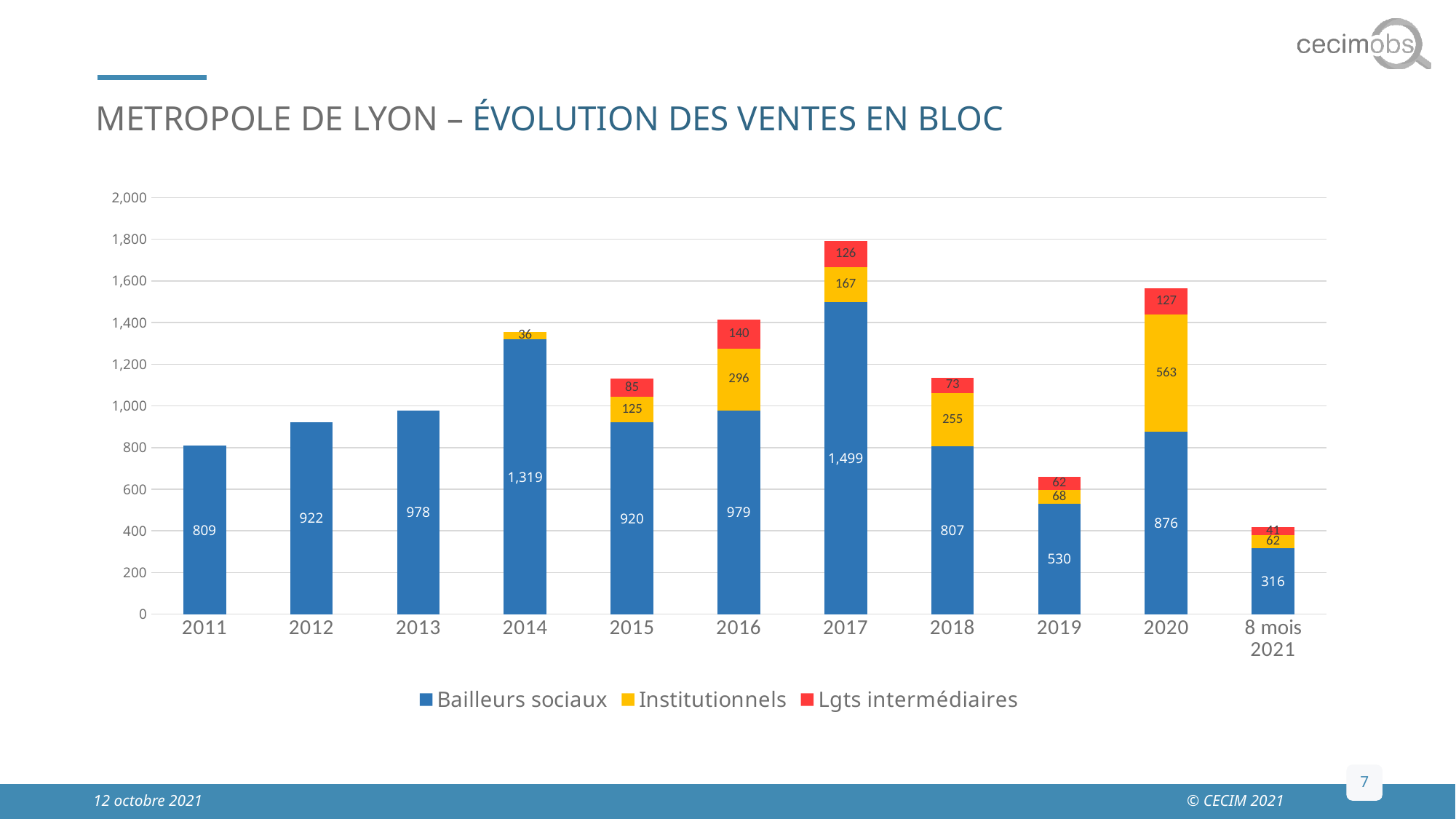
What is the value for Bailleurs sociaux in 2017? 1,499 What is the value for Institutionnels in 2020? 563 What is the difference between the Institutionnels values for 2020 and 2016? 267 What kind of chart is shown on the slide? Stacked bar chart How many series does the legend list? 3 What is the value for Lgts intermédiaires in 2016? 140 What is the total of the stacked bar for 2017? 1,792 Which category has the lowest Bailleurs sociaux value? 8 mois 2021 How many categories are shown on the x axis? 11 Is the total for 2012 greater or less than 1,000? less Which is larger, the Bailleurs sociaux value for 2014 or for 2017? 2017 In which year is the Bailleurs sociaux value highest? 2017